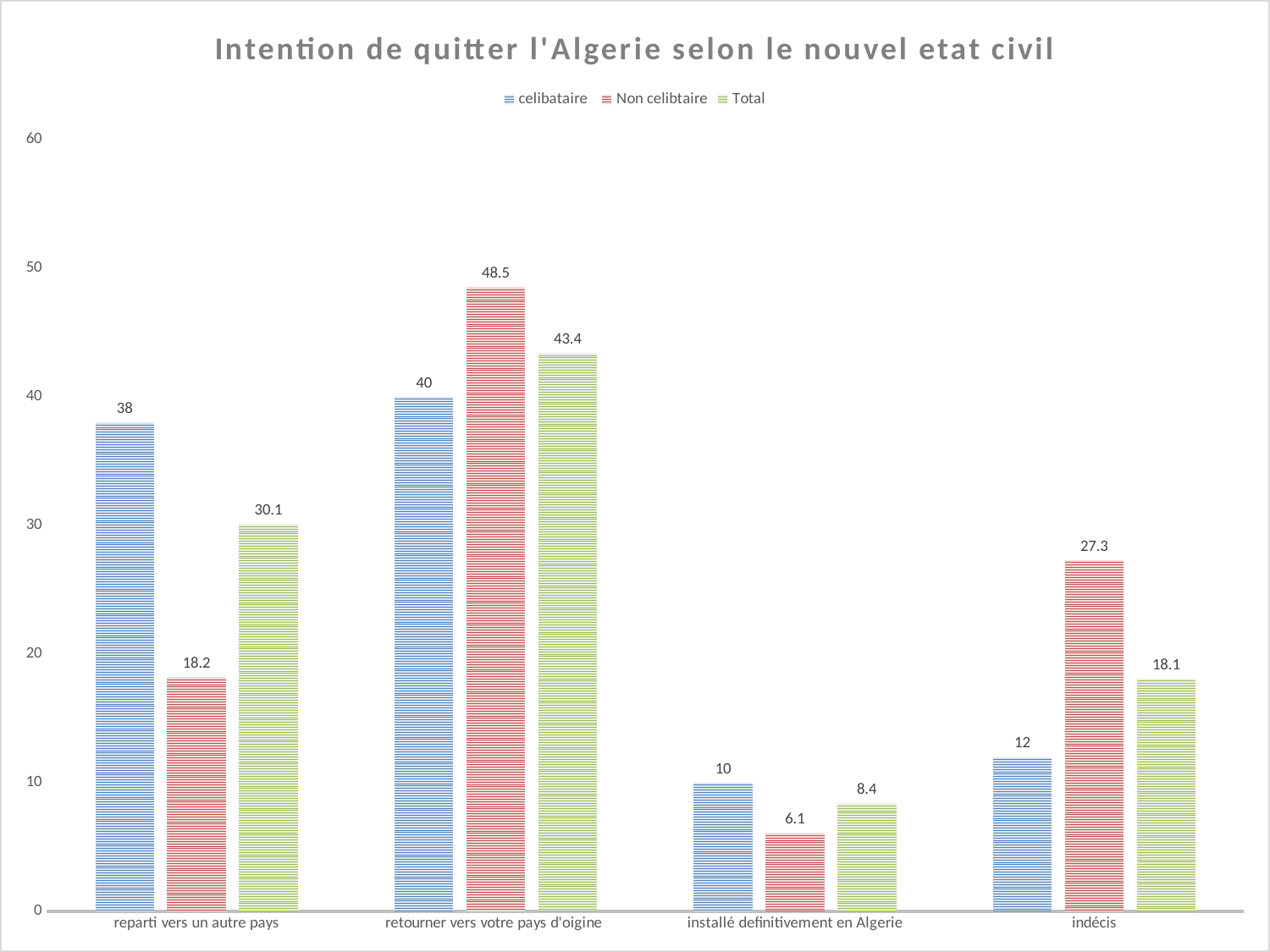
What is the difference between the 'Total' values for 'retourner vers votre pays d'oigine' and 'installé definitivement en Algerie'? 35 Which category has the lowest 'Non celibtaire' value? installé definitivement en Algerie What is the title of the chart? Intention de quitter l'Algerie selon le nouvel etat civil What is the 'Total' value for the 'indécis' category? 18.1 What is the difference between the 'celibataire' and 'Non celibtaire' values in the 'reparti vers un autre pays' category? 19.8 How many series does the legend list? 3 What is the value for 'Non celibtaire' in the 'retourner vers votre pays d'oigine' category? 48.5 How many categories are shown on the x axis? 4 What kind of chart is shown on the slide? bar chart What is the value for 'celibataire' in the 'reparti vers un autre pays' category? 38 Which category has the highest 'Total' value? retourner vers votre pays d'oigine Which is larger in the 'indécis' category: 'celibataire' or 'Non celibtaire'? Non celibtaire